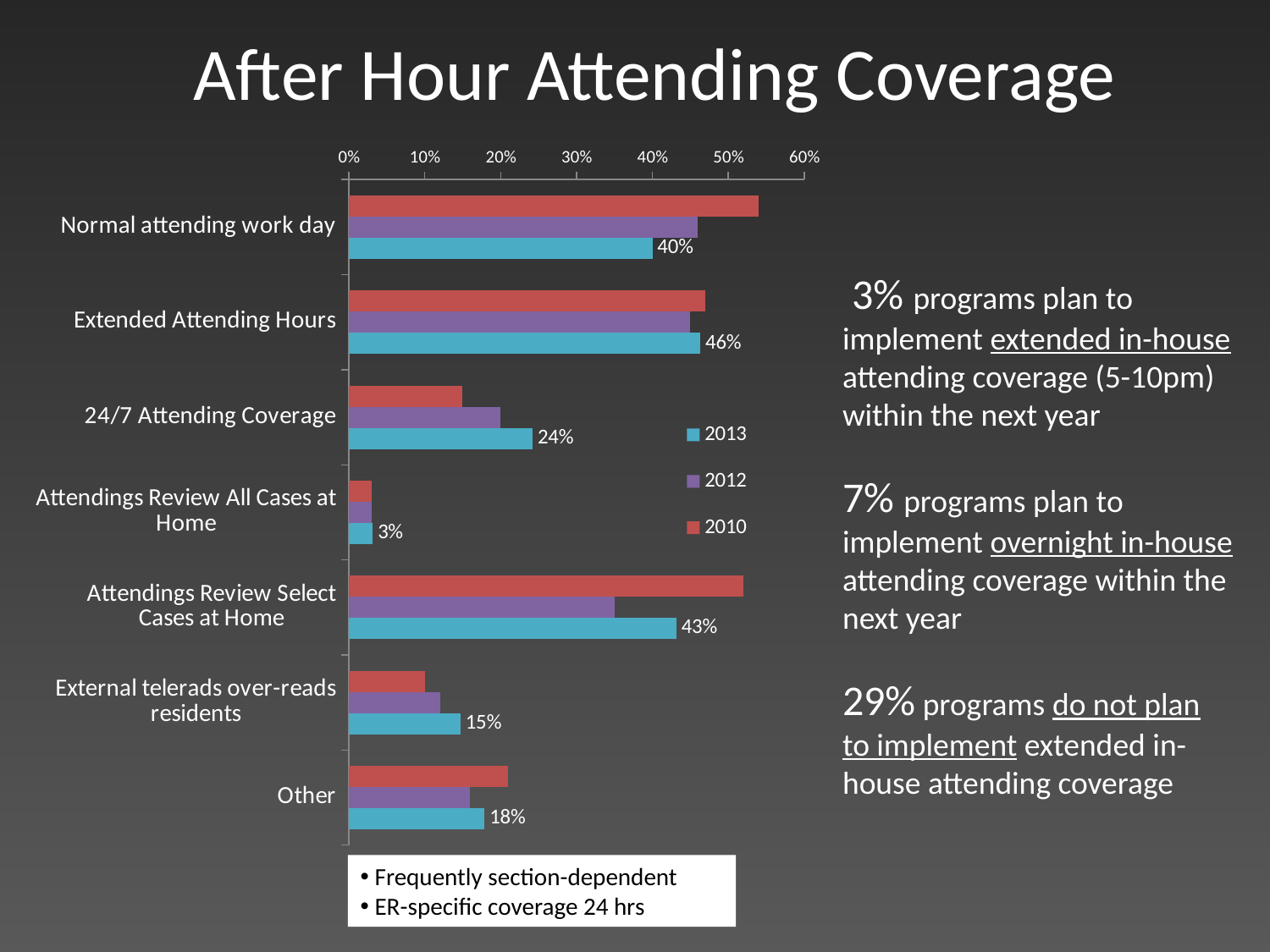
How many categories are plotted on the chart? 7 Which category has the lowest 2013 value? Attendings Review All Cases at Home Is the 2010 value for Normal attending work day greater or less than 50%? greater What is the difference between the 2013 values for Extended Attending Hours and Normal attending work day? 6 percentage points How many series does the chart legend list? 3 What kind of chart is shown on the slide? bar chart What is the 2013 value for External telerads over-reads residents? 15% Which category has the highest 2013 value? Extended Attending Hours Which years are listed in the chart legend? 2013, 2012, 2010 Which is larger for 2013: Attendings Review Select Cases at Home or 24/7 Attending Coverage? Attendings Review Select Cases at Home What is the 2013 value for Attendings Review Select Cases at Home? 43% What is the 2013 value for Extended Attending Hours? 46%